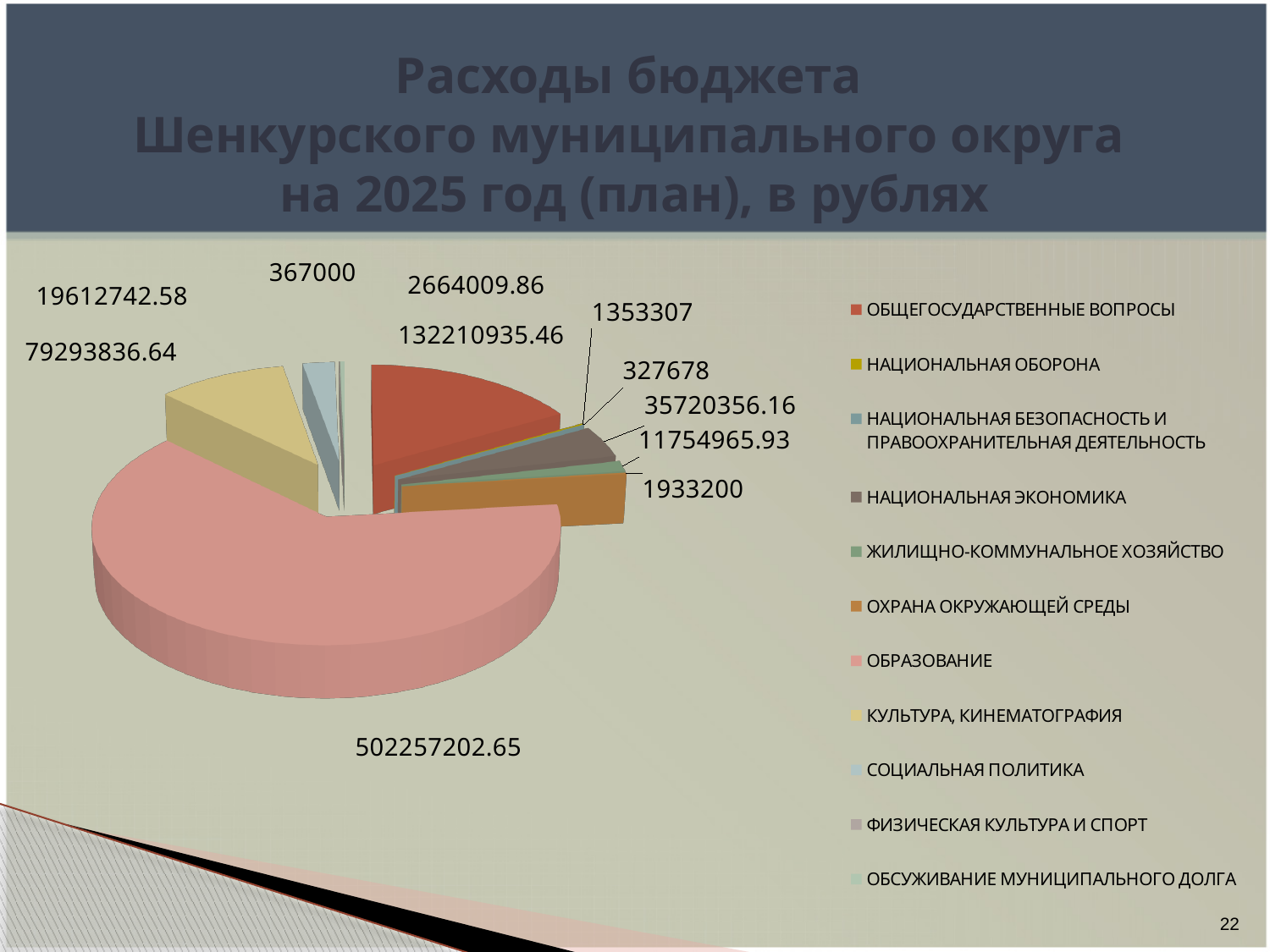
Which category has the largest slice in the pie chart? ОБРАЗОВАНИЕ What type of chart is shown on the slide? Pie chart How many categories does the legend of the pie chart list? 11 What is the value shown for ФИЗИЧЕСКАЯ КУЛЬТУРА И СПОРТ? 367000 What is the value shown for ОБРАЗОВАНИЕ? 502257202.65 What is the value shown for ОБЩЕГОСУДАРСТВЕННЫЕ ВОПРОСЫ? 132210935.46 What is the difference between the value for ОБРАЗОВАНИЕ and the value for ОБЩЕГОСУДАРСТВЕННЫЕ ВОПРОСЫ? 370046267.19 What is the value shown for СОЦИАЛЬНАЯ ПОЛИТИКА? 19612742.58 Which category has the smallest value in the pie chart? НАЦИОНАЛЬНАЯ БЕЗОПАСНОСТЬ И ПРАВООХРАНИТЕЛЬНАЯ ДЕЯТЕЛЬНОСТЬ What is the value shown for НАЦИОНАЛЬНАЯ ЭКОНОМИКА? 35720356.16 What is the value shown for КУЛЬТУРА, КИНЕМАТОГРАФИЯ? 79293836.64 Which is larger, the value for ОБЩЕГОСУДАРСТВЕННЫЕ ВОПРОСЫ or the value for КУЛЬТУРА, КИНЕМАТОГРАФИЯ? ОБЩЕГОСУДАРСТВЕННЫЕ ВОПРОСЫ